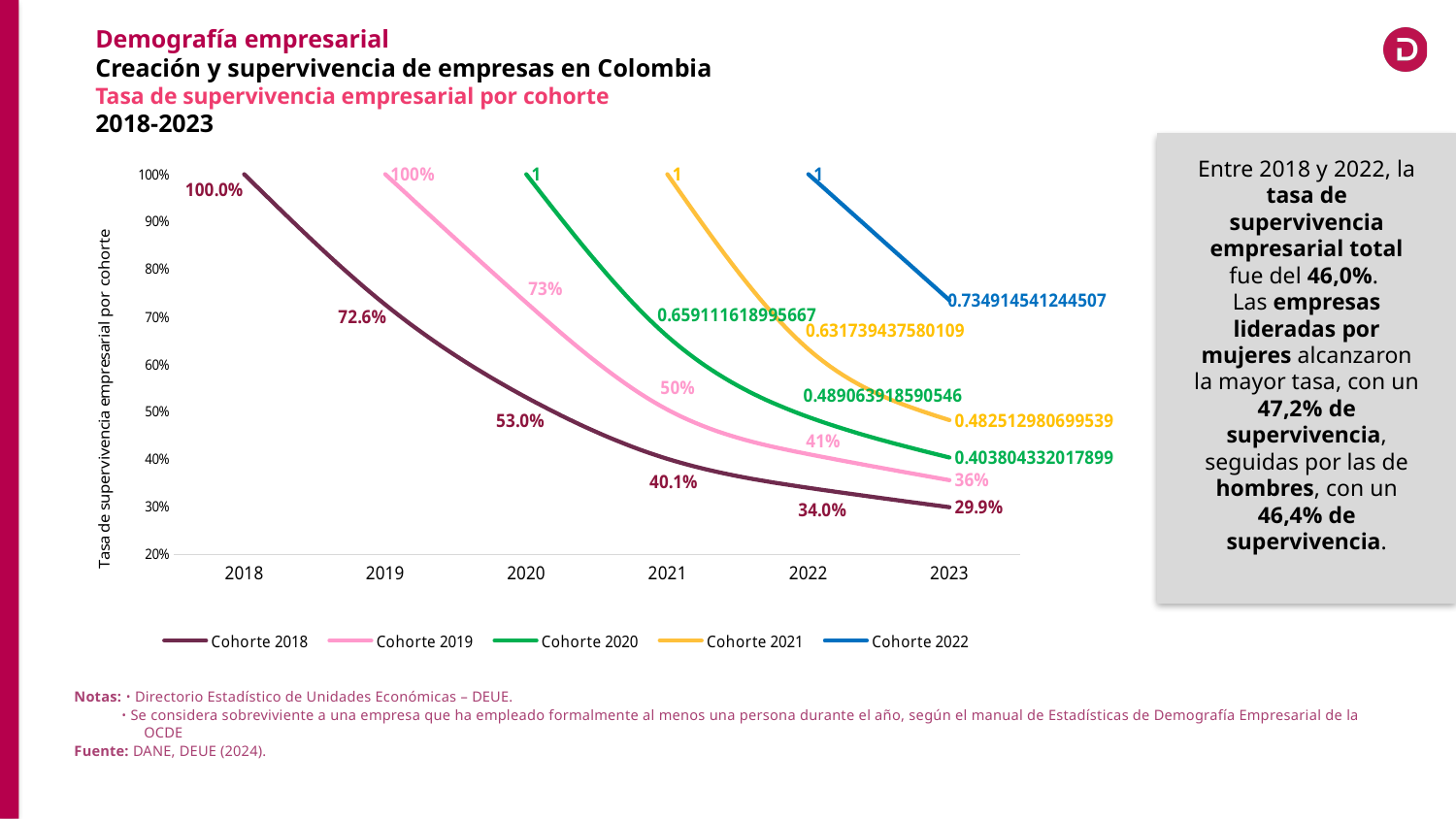
Which is higher in 2023: the survival rate of Cohorte 2019 or Cohorte 2021? Cohorte 2021 What is the survival rate of Cohorte 2019 in 2021? 50% What value is labelled for Cohorte 2022 in 2023? 0.734914541244507 In 2023, which cohort has the lowest survival rate? Cohorte 2018 What kind of chart is shown on the slide? Line chart How many years are shown on the x axis? 6 Does the survival rate of each cohort rise or fall over the years along the x axis? Fall What value is labelled for Cohorte 2020 in 2023? 0.403804332017899 What is the survival rate of Cohorte 2018 in 2023? 29.9% How many series does the legend list? 5 What is the survival rate of Cohorte 2018 in 2020? 53.0% By how many percentage points did the survival rate of Cohorte 2018 fall between 2019 and 2020? 19.6 percentage points